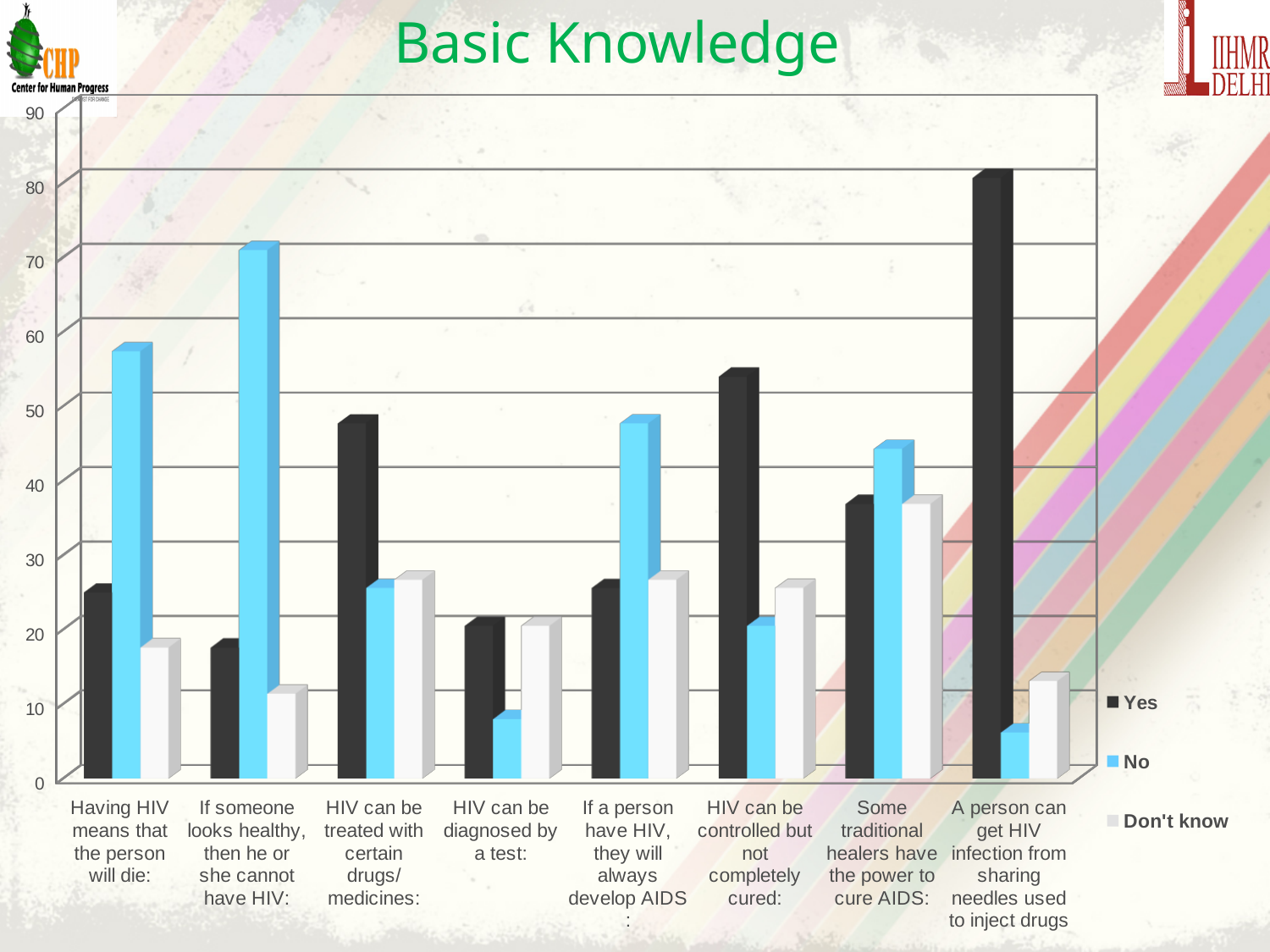
Is the 'No' value for 'If someone looks healthy, then he or she cannot have HIV' greater or less than 60? greater Which statement has the highest 'Yes' value? A person can get HIV infection from sharing needles used to inject drugs For 'Having HIV means that the person will die', which is larger, the 'Yes' value or the 'No' value? No For 'HIV can be treated with certain drugs/medicines', which is larger, the 'Yes' value or the 'No' value? Yes Is the 'Yes' value for 'A person can get HIV infection from sharing needles used to inject drugs' greater or less than 70? greater What kind of chart is shown on the slide? Bar chart Which statement has the highest 'No' value? If someone looks healthy, then he or she cannot have HIV Is the 'No' value for 'HIV can be diagnosed by a test' greater or less than 10? less Which statement has the highest 'Don't know' value? Some traditional healers have the power to cure AIDS What is the title of the chart? Basic Knowledge How many series does the legend list? 3 How many statement categories are shown along the x axis? 8